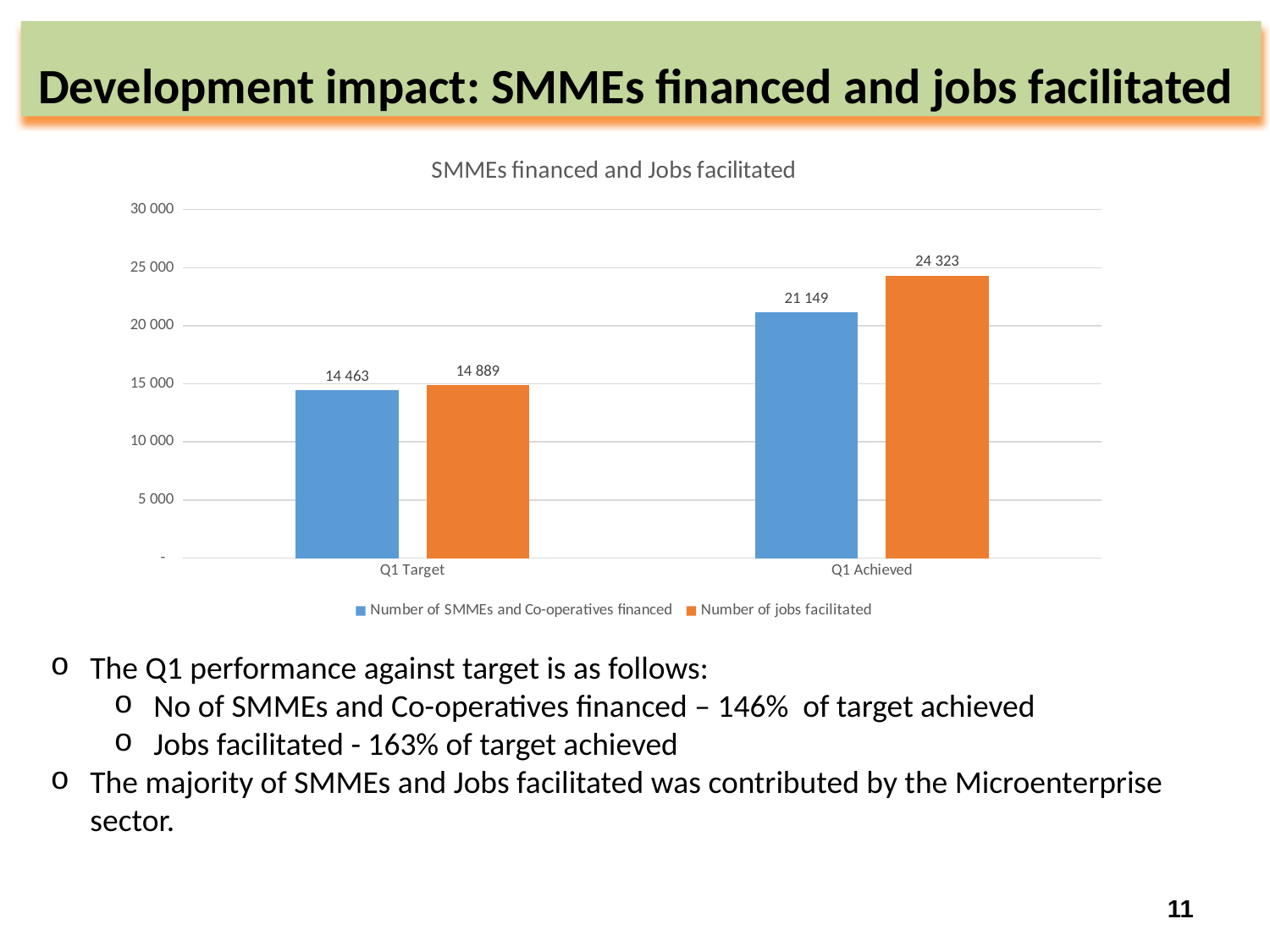
What is the Q1 Target value for Number of jobs facilitated? 14 889 What kind of chart is shown on the slide? Bar chart What is the Q1 Target value for Number of SMMEs and Co-operatives financed? 14 463 How many series does the legend list? 2 What is the Q1 Achieved value for Number of SMMEs and Co-operatives financed? 21 149 Which bar in the chart has the lowest value? Number of SMMEs and Co-operatives financed, Q1 Target What is the difference between the Q1 Achieved and Q1 Target values for Number of SMMEs and Co-operatives financed? 6 686 Which bar in the chart has the highest value? Number of jobs facilitated, Q1 Achieved What is the Q1 Achieved value for Number of jobs facilitated? 24 323 What is the title of the chart? SMMEs financed and Jobs facilitated Which is larger: the Q1 Achieved value for Number of SMMEs and Co-operatives financed or the Q1 Achieved value for Number of jobs facilitated? Number of jobs facilitated What is the difference between the Q1 Achieved and Q1 Target values for Number of jobs facilitated? 9 434